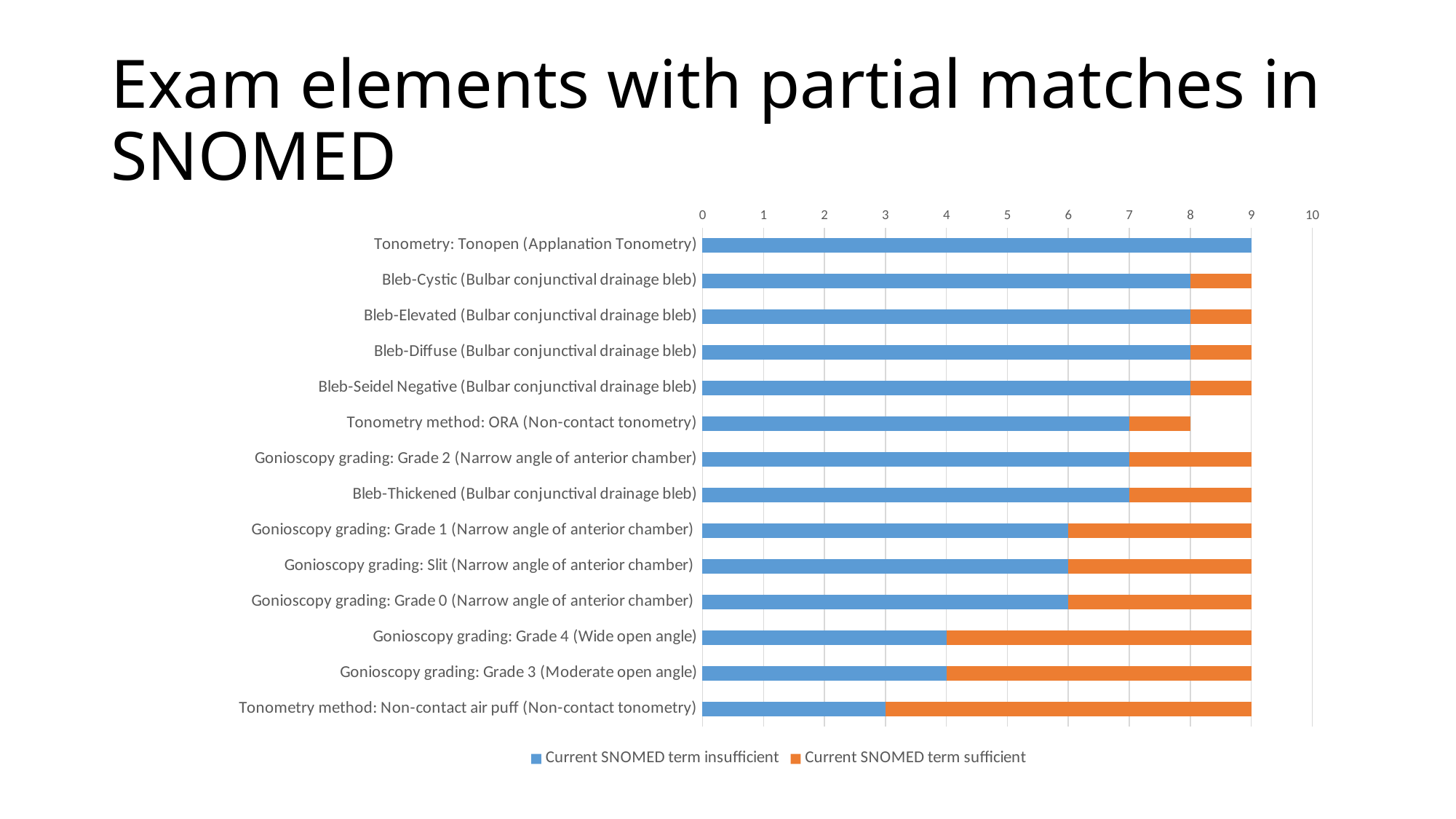
What is the 'Current SNOMED term insufficient' value for Tonometry: Tonopen (Applanation Tonometry)? 9 How many series does the legend list? 2 Which is larger: the 'Current SNOMED term insufficient' value for Gonioscopy grading: Grade 1 (Narrow angle of anterior chamber) or for Gonioscopy grading: Grade 4 (Wide open angle)? Gonioscopy grading: Grade 1 (Narrow angle of anterior chamber) What is the difference between the 'Current SNOMED term insufficient' values for Bleb-Cystic (Bulbar conjunctival drainage bleb) and Gonioscopy grading: Grade 3 (Moderate open angle)? 4 What is the 'Current SNOMED term insufficient' value for Tonometry method: Non-contact air puff (Non-contact tonometry)? 3 Which exam element has the highest 'Current SNOMED term sufficient' value? Tonometry method: Non-contact air puff (Non-contact tonometry) What is the 'Current SNOMED term sufficient' value for Gonioscopy grading: Grade 4 (Wide open angle)? 5 Which exam element has the highest 'Current SNOMED term insufficient' value? Tonometry: Tonopen (Applanation Tonometry) Which colour represents 'Current SNOMED term sufficient' in the chart? Orange How many exam elements (categories) are listed on the chart? 14 What kind of chart is shown on the slide? Stacked bar chart What is the total bar length for Tonometry method: ORA (Non-contact tonometry)? 8